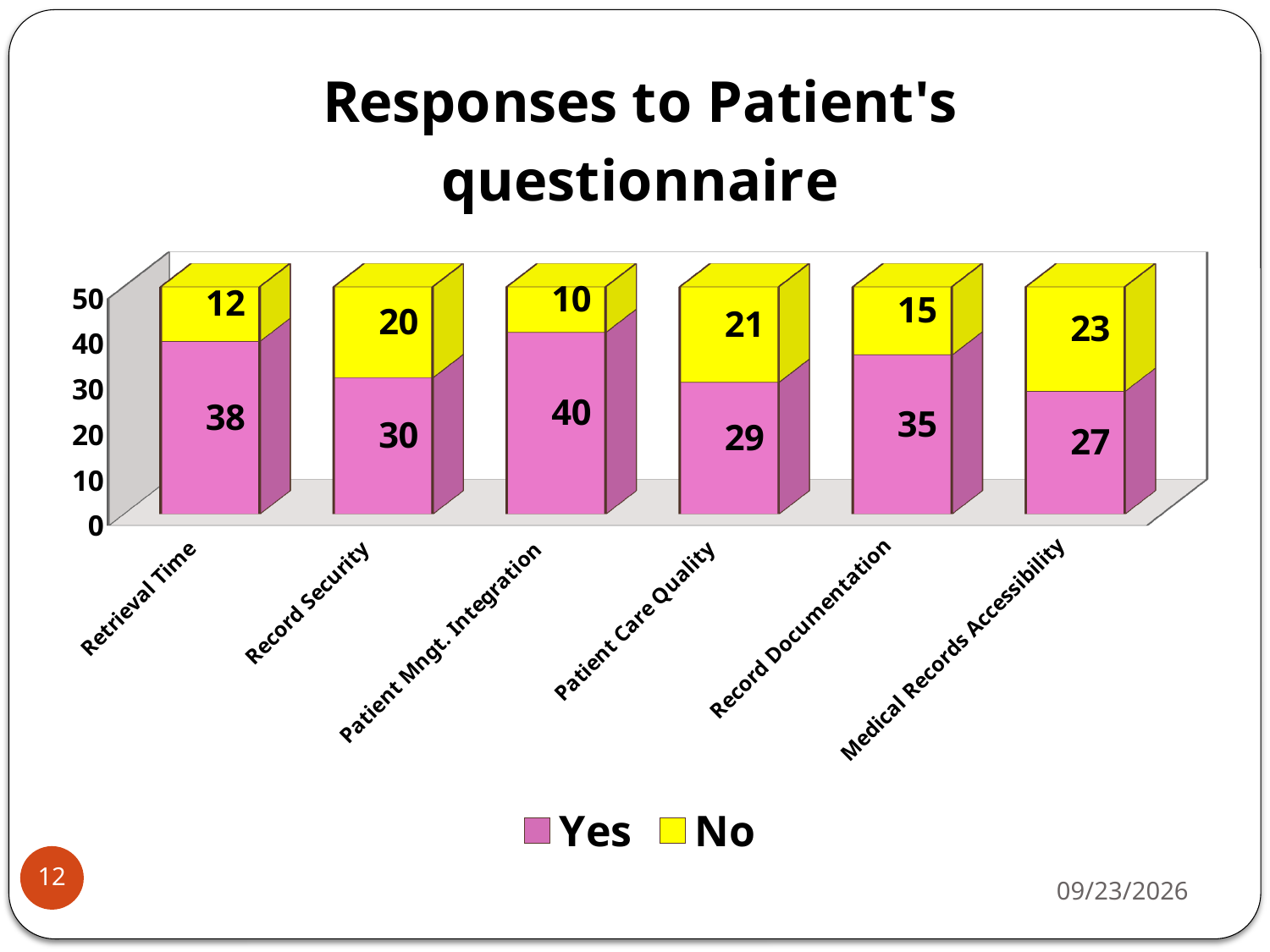
What kind of chart is shown on the slide? Stacked bar chart Which is larger, the Yes value for Patient Care Quality or the Yes value for Record Documentation? Record Documentation What is the total of the stacked bar for Retrieval Time? 50 Which category has the lowest Yes value? Medical Records Accessibility What is the Yes value for Retrieval Time? 38 How many series does the legend list? 2 Which category has the highest Yes value? Patient Mngt. Integration What is the No value for Medical Records Accessibility? 23 What is the difference between the Yes and No values for Record Security? 10 What is the Yes value for Record Documentation? 35 How many categories are shown on the x axis? 6 Which category has the lowest No value? Patient Mngt. Integration